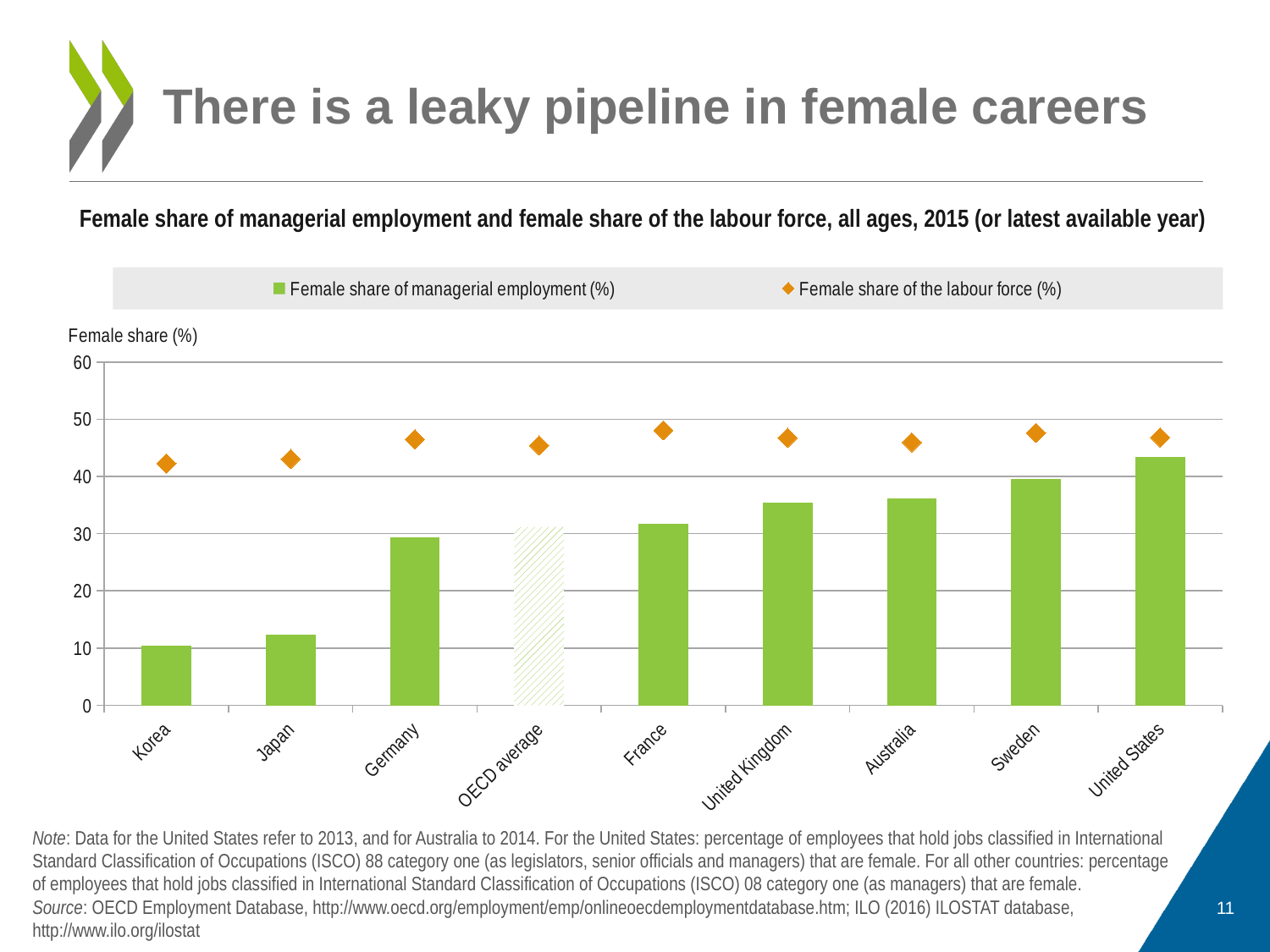
Which has a larger female share of managerial employment, Sweden or Germany? Sweden Which category has the highest female share of managerial employment? United States Which series is shown with orange diamond markers? Female share of the labour force (%) Is the female share of managerial employment for the United Kingdom greater or less than 30? greater Is the female share of the labour force for France greater or less than 40? greater How many series does the legend list? 2 Do the female share of managerial employment bars generally rise or fall from Korea to the United States along the x axis? rise How many countries or categories are shown on the x axis? 9 Which category has the lowest female share of managerial employment? Korea Is the female share of managerial employment for Korea greater or less than 20? less What kind of chart is shown on the slide? bar chart with diamond markers